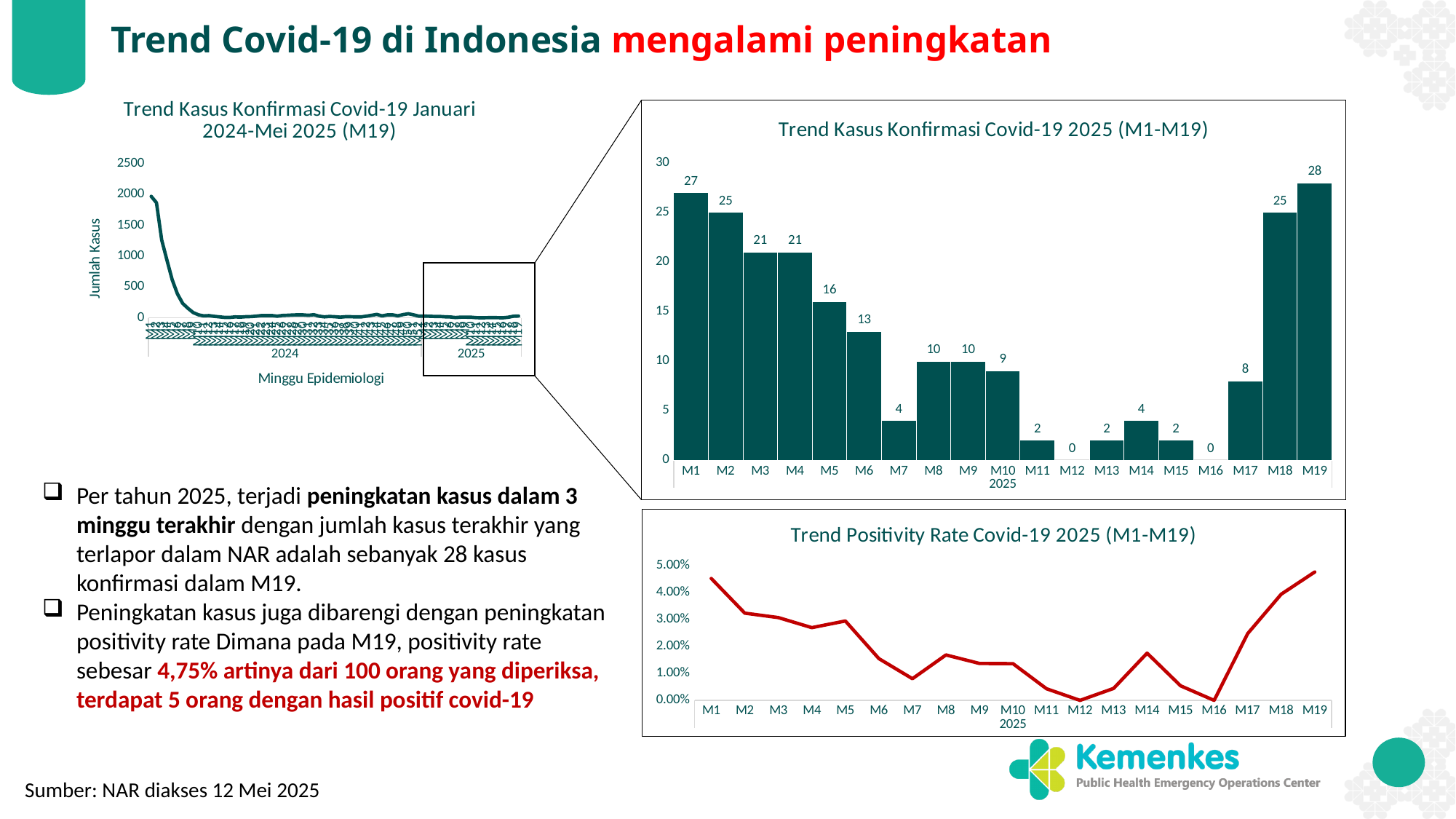
In the chart titled 'Trend Positivity Rate Covid-19 2025 (M1-M19)', do the values rise or fall from M16 to M19? rise In the chart titled 'Trend Kasus Konfirmasi Covid-19 2025 (M1-M19)', which week has the highest value? M19 In the chart titled 'Trend Positivity Rate Covid-19 2025 (M1-M19)', is the value for M1 greater or less than 4.00%? greater What kind of chart is 'Trend Kasus Konfirmasi Covid-19 2025 (M1-M19)'? bar chart In the chart titled 'Trend Kasus Konfirmasi Covid-19 2025 (M1-M19)', how many weeks are shown on the x axis? 19 In the chart titled 'Trend Kasus Konfirmasi Covid-19 2025 (M1-M19)', which is larger, the value for M5 or the value for M6? M5 In the chart titled 'Trend Kasus Konfirmasi Covid-19 2025 (M1-M19)', which weeks have a value of 0? M12 and M16 In the chart titled 'Trend Kasus Konfirmasi Covid-19 2025 (M1-M19)', what is the value for M19? 28 In the chart titled 'Trend Positivity Rate Covid-19 2025 (M1-M19)', is the value for M12 greater or less than 1.00%? less What kind of chart is 'Trend Kasus Konfirmasi Covid-19 Januari 2024-Mei 2025 (M19)'? line chart In the chart titled 'Trend Kasus Konfirmasi Covid-19 2025 (M1-M19)', what is the difference between the values for M19 and M18? 3 In the chart titled 'Trend Kasus Konfirmasi Covid-19 2025 (M1-M19)', what is the value for M1? 27